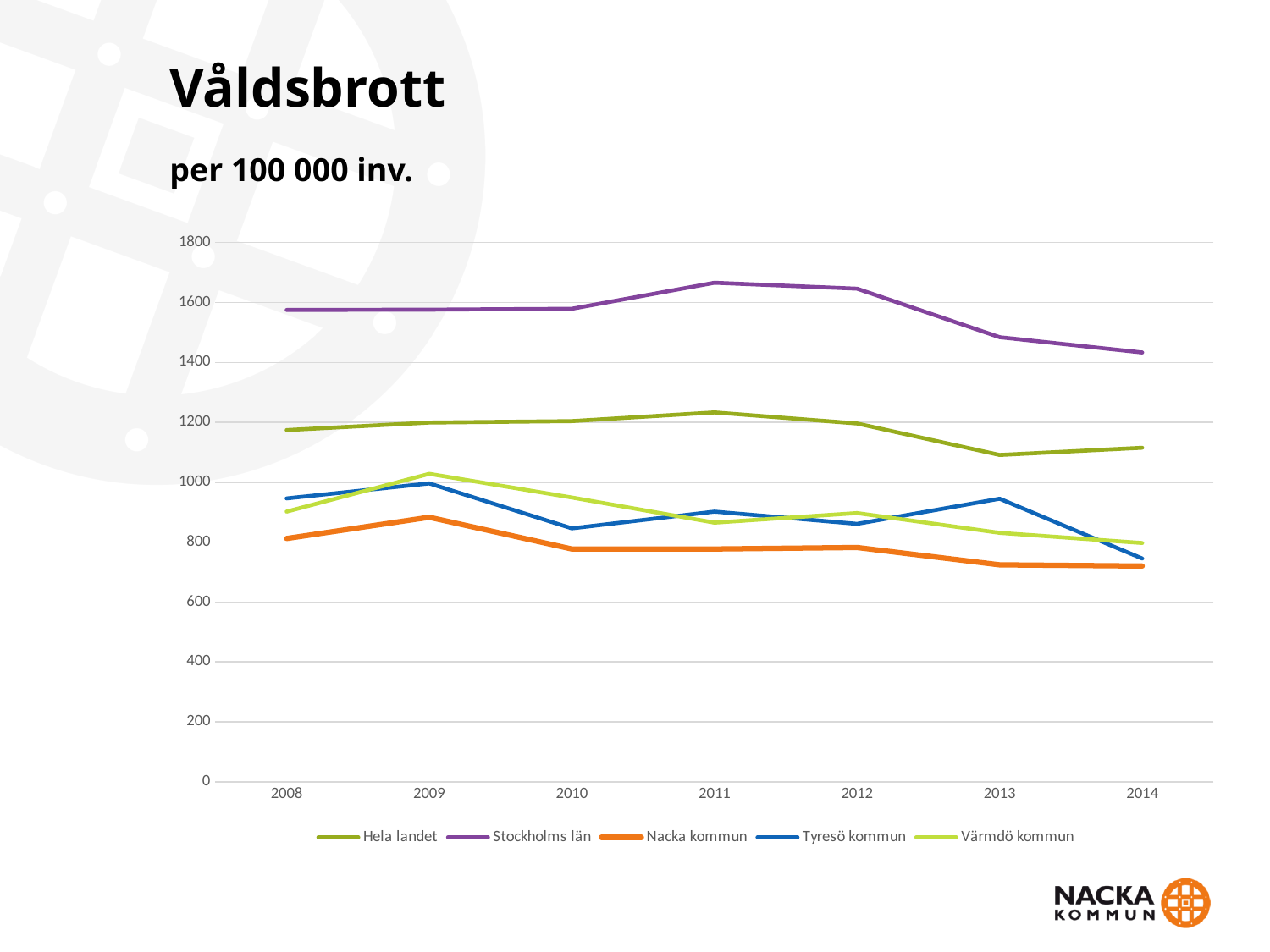
Is the value for Hela landet in 2013 greater or less than 1200? less In 2013, which is higher: Tyresö kommun or Värmdö kommun? Tyresö kommun What is the title of the chart? Våldsbrott per 100 000 inv. Is the value for Tyresö kommun in 2010 greater or less than 900? less Which series has the lowest value in 2013? Nacka kommun How many years are shown on the x axis? 7 How many series does the legend list? 5 Is the value for Stockholms län in 2011 greater or less than 1600? greater Which series has the highest value in 2011? Stockholms län Does the Stockholms län line rise or fall from 2011 to 2014? fall What kind of chart is shown on the slide? line chart